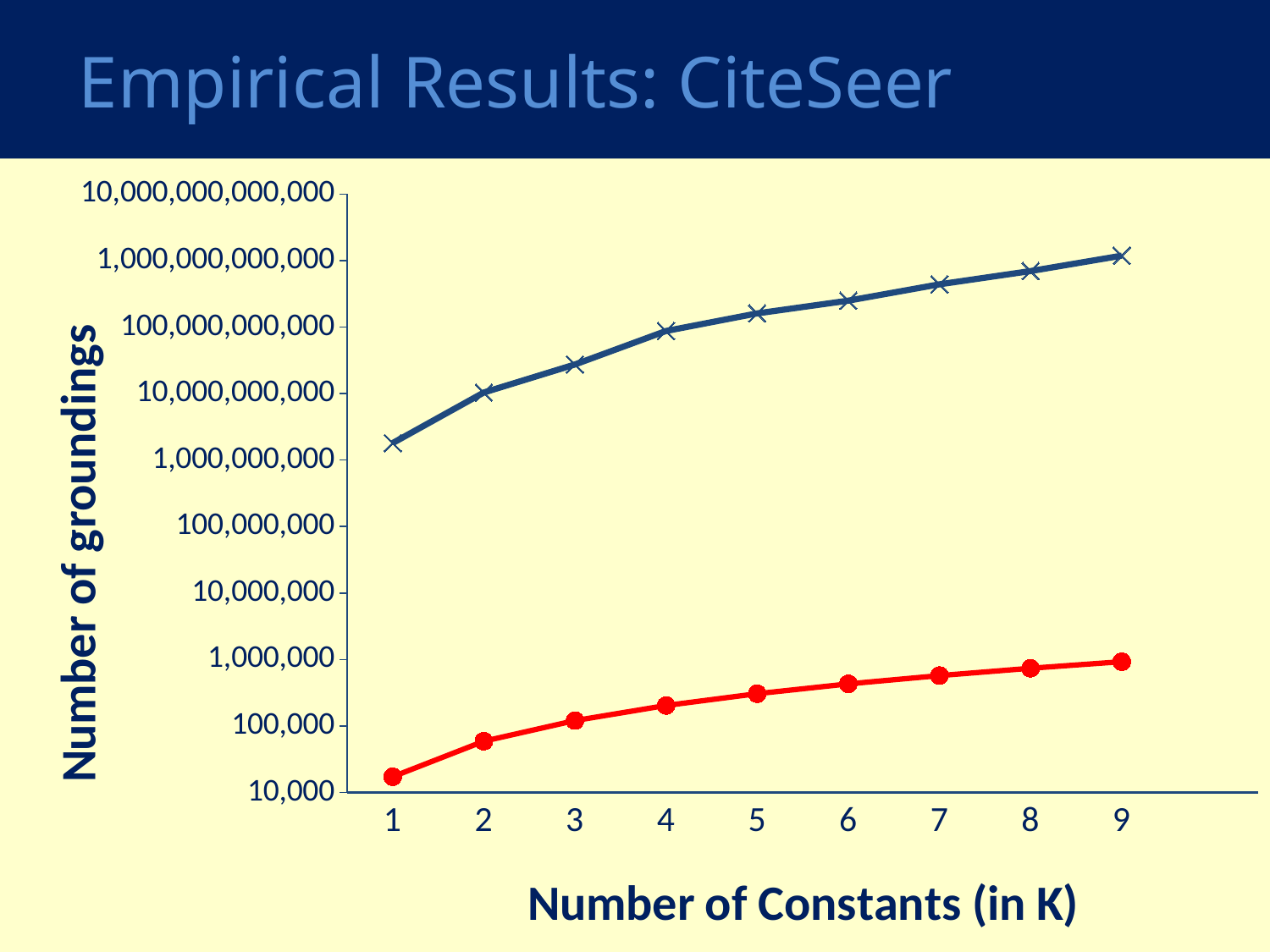
How many data points does each line have along the x axis? 9 How many lines are plotted on the chart? 2 Do the values of the red line with circle markers rise or fall as the number of constants increases? rise What kind of chart is shown on the slide? line chart What is the title of the x axis? Number of Constants (in K) Is the value of the red line at 5 on the x axis greater or less than 1,000,000? less What is the title of the y axis? Number of groundings Is the value of the red line at 2 on the x axis greater or less than 100,000? less Is the value of the blue line at 1 on the x axis greater or less than 1,000,000,000? greater Do the values of the blue line with x markers rise or fall as the number of constants increases? rise At 5 on the x axis, which line has the larger value, the blue line or the red line? the blue line At which number of constants does the blue line reach its highest value? 9